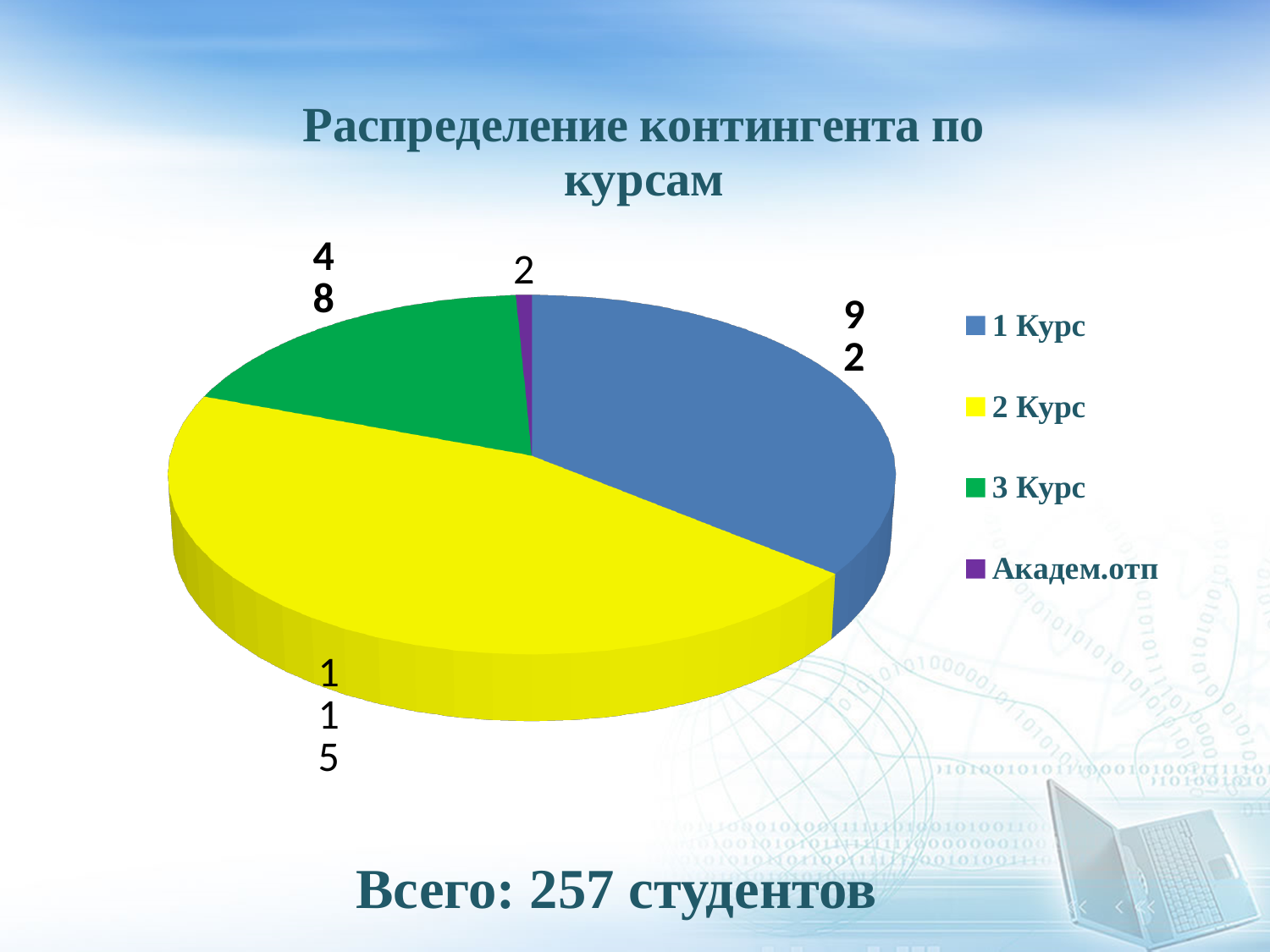
How many categories does the pie chart show? 4 What is the value for 3 Курс in the pie chart? 48 What is the difference between the values for 2 Курс and 1 Курс? 23 What is the value for 2 Курс in the pie chart? 115 What is the value for 1 Курс in the pie chart? 92 What is the difference between the values for 1 Курс and 3 Курс? 44 Which category has the largest slice in the pie chart? 2 Курс What kind of chart is shown on the slide? Pie chart What is the value for Академ.отп in the pie chart? 2 Which is larger, the value for 1 Курс or the value for 3 Курс? 1 Курс Which category has the smallest slice in the pie chart? Академ.отп What is the total number of students across all slices of the pie chart? 257